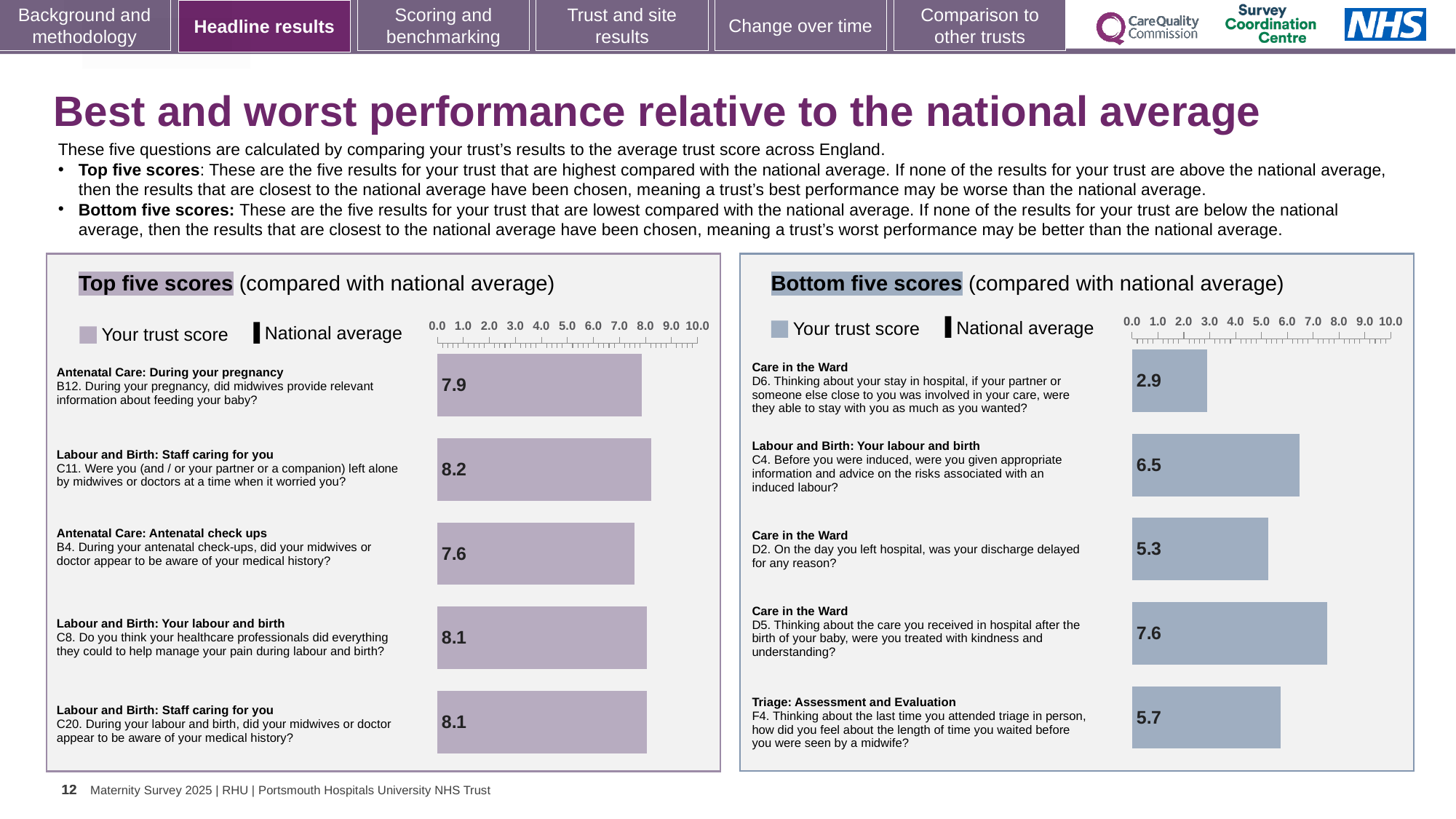
In the Bottom five scores chart, what is the trust score for question D6 (was your partner able to stay with you as much as you wanted?)? 2.9 In the Bottom five scores chart, is the score for D2 greater or less than 5.0? greater In the Top five scores chart, which question has the lowest trust score? B4 (7.6) How many entries does the legend of the Bottom five scores chart list? 2 In the Bottom five scores chart, which question has the lowest trust score? D6 (2.9) In the Top five scores chart, which question has the highest trust score? C11 (8.2) In the Bottom five scores chart, what is the difference between the scores for D5 and D6? 4.7 In the Top five scores chart, how many questions (bars) are shown? 5 In the Top five scores chart, what is the trust score for question B12 (During your pregnancy, did midwives provide relevant information about feeding your baby?)? 7.9 In the Bottom five scores chart, which has the larger score: C4 or F4? C4 What type of chart is used in the Top five scores panel? Bar chart In the Bottom five scores chart, which question has the highest trust score? D5 (7.6)